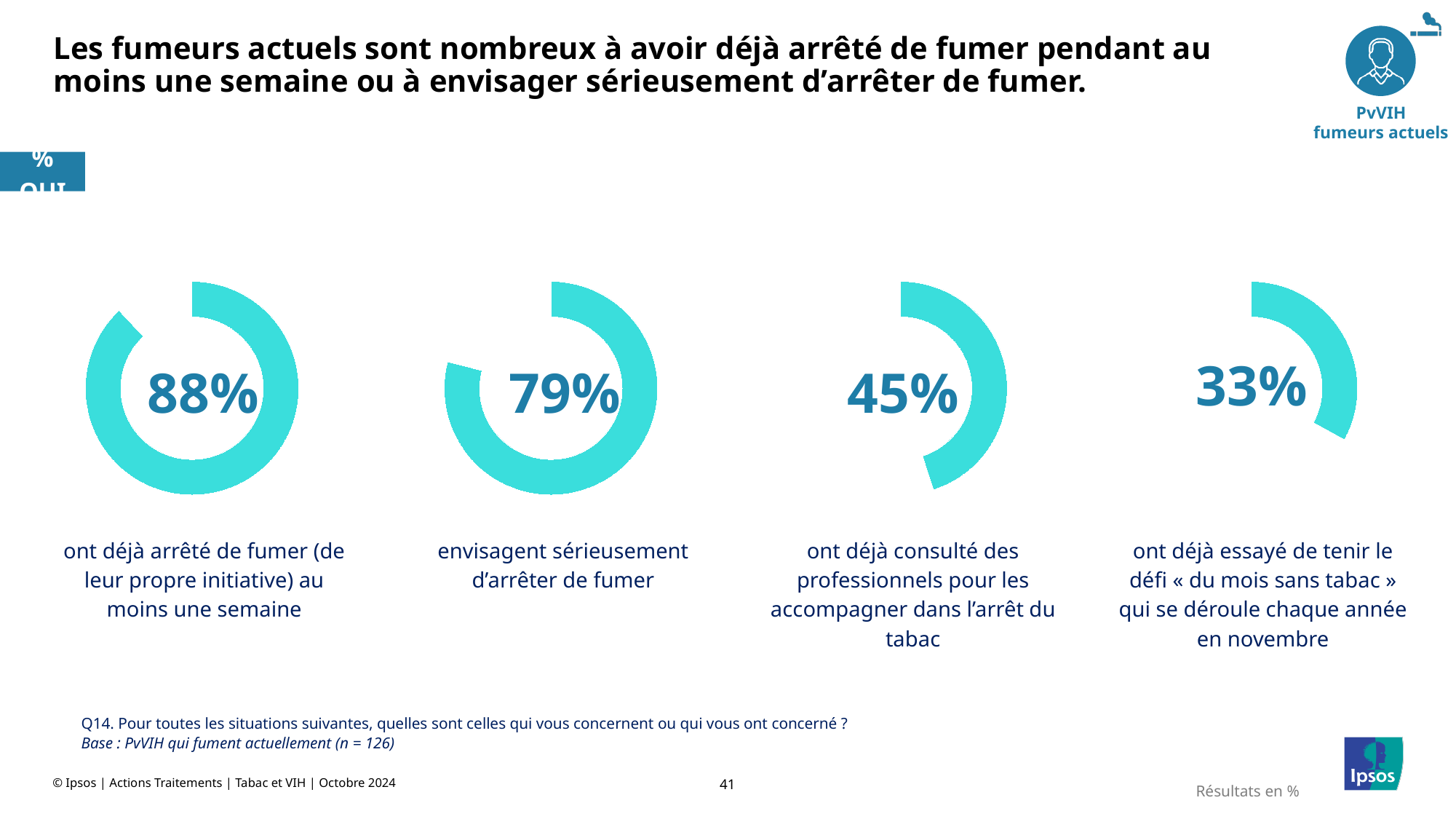
What is the difference in percentage points between the first donut chart (88%) and the second donut chart (79%)? 9 percentage points Which of the four donut charts shows the lowest percentage? 33% (ont déjà essayé de tenir le défi « du mois sans tabac ») What type of chart is used to display the percentages on this slide? Donut chart What is the base (sample size) indicated for the data on this slide? n = 126 What percentage of current smokers have already stopped smoking (on their own initiative) for at least a week, according to the first donut chart? 88% In the second donut chart, what share of respondents seriously consider quitting smoking? 79% Which of the four donut charts shows the highest percentage? 88% (ont déjà arrêté de fumer au moins une semaine) Which is larger: the share who seriously consider quitting or the share who have consulted professionals? The share who seriously consider quitting (79%) What is the difference between the value for consulting professionals (45%) and the value for the 'mois sans tabac' challenge (33%)? 12 percentage points What value is shown in the third donut chart, for those who have already consulted professionals to help them quit tobacco? 45% What percentage is shown in the fourth (rightmost) donut chart, for those who have already tried the 'mois sans tabac' challenge? 33% How many donut charts are shown on the slide? 4